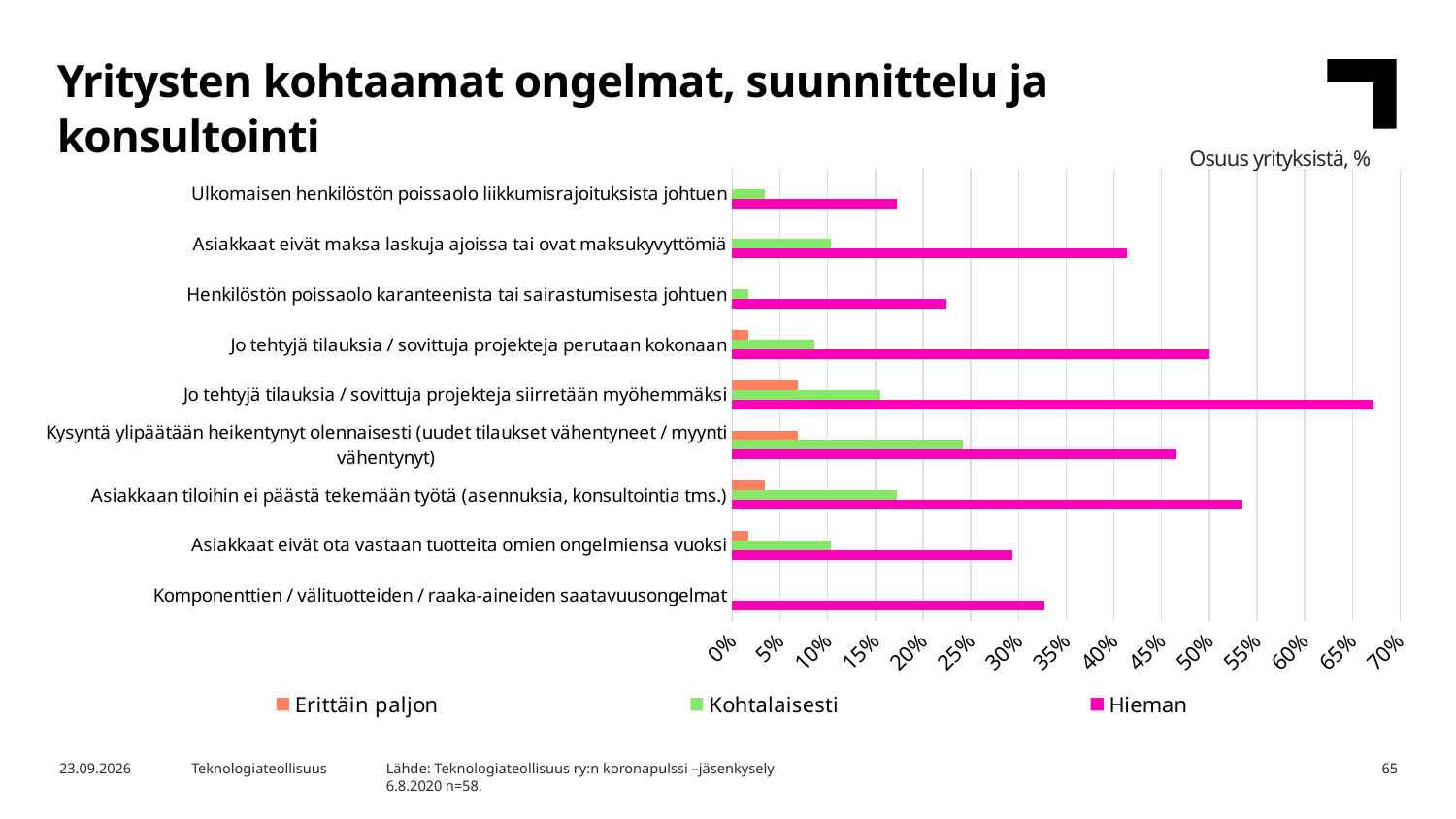
What kind of chart is shown on the slide? bar chart Is the 'Hieman' value for 'Henkilöstön poissaolo karanteenista tai sairastumisesta johtuen' greater or less than 25%? less How many series does the legend list? 3 Is the 'Kohtalaisesti' value for 'Kysyntä ylipäätään heikentynyt olennaisesti' greater or less than 20%? greater Which category has the highest value for the 'Hieman' series? Jo tehtyjä tilauksia / sovittuja projekteja siirretään myöhemmäksi How many categories are plotted on the chart? 9 Which category has the highest value for the 'Kohtalaisesti' series? Kysyntä ylipäätään heikentynyt olennaisesti (uudet tilaukset vähentyneet / myynti vähentynyt) What unit label is shown above the chart? Osuus yrityksistä, % Is the 'Hieman' value for 'Jo tehtyjä tilauksia / sovittuja projekteja siirretään myöhemmäksi' greater or less than 60%? greater For the 'Hieman' series, which is larger: 'Asiakkaan tiloihin ei päästä tekemään työtä' or 'Asiakkaat eivät maksa laskuja ajoissa tai ovat maksukyvyttömiä'? Asiakkaan tiloihin ei päästä tekemään työtä Which category has the lowest value for the 'Hieman' series? Ulkomaisen henkilöstön poissaolo liikkumisrajoituksista johtuen